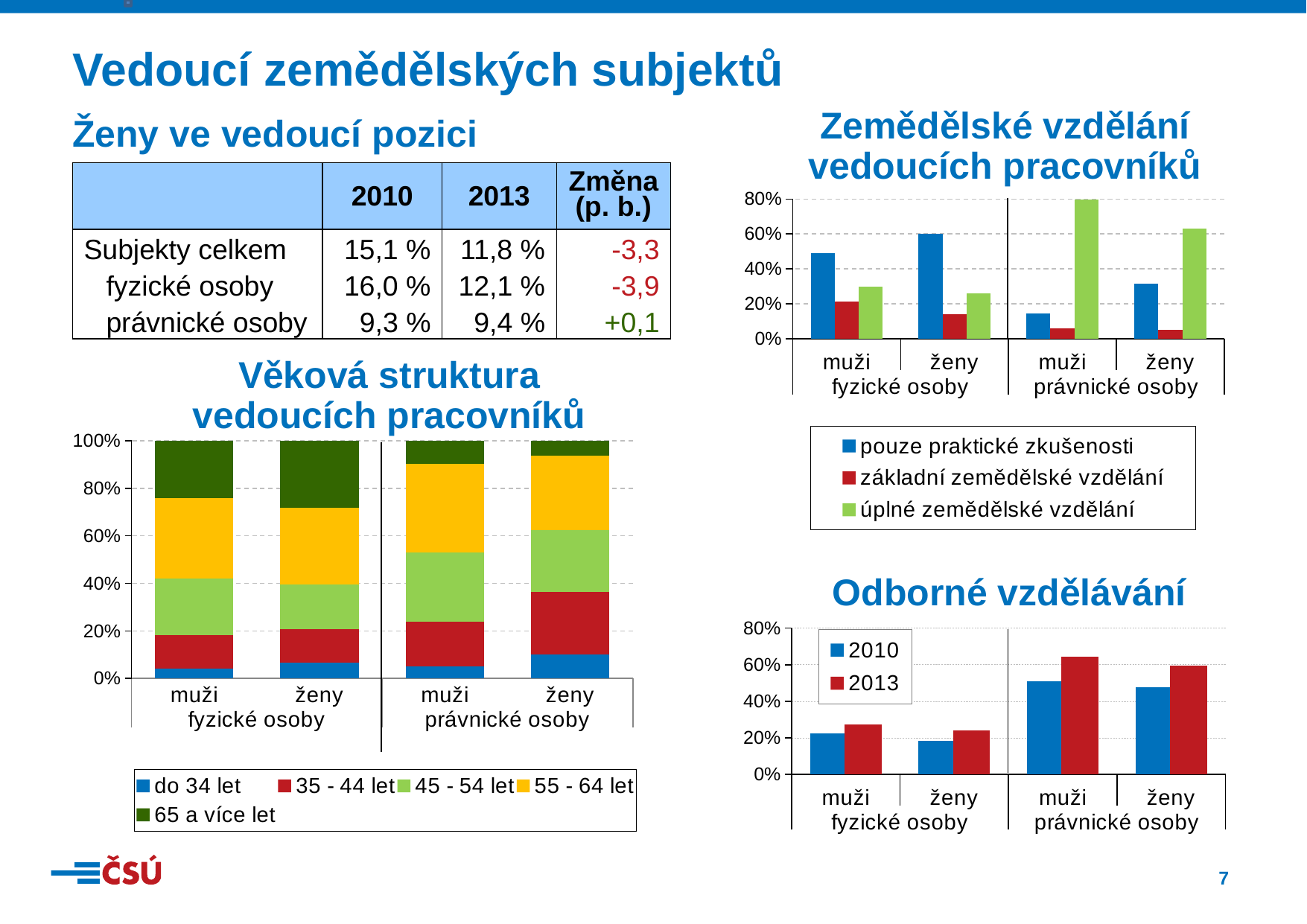
In the chart 'Věková struktura vedoucích pracovníků', how many age groups does the legend list? 5 In the chart 'Zemědělské vzdělání vedoucích pracovníků', how many categories are shown on the x axis? 4 In the chart 'Zemědělské vzdělání vedoucích pracovníků', for muži (fyzické osoby), which is larger: 'pouze praktické zkušenosti' or 'úplné zemědělské vzdělání'? pouze praktické zkušenosti In the chart 'Zemědělské vzdělání vedoucích pracovníků', is the value of 'pouze praktické zkušenosti' for ženy (fyzické osoby) greater or less than 40%? greater In the chart 'Odborné vzdělávání', which category has the highest value for 2013? muži, právnické osoby In the chart 'Odborné vzdělávání', how many series does the legend list? 2 In the chart 'Zemědělské vzdělání vedoucích pracovníků', which category has the highest value for 'úplné zemědělské vzdělání'? muži, právnické osoby In the chart 'Věková struktura vedoucích pracovníků', is the share of 'do 34 let' for muži (fyzické osoby) greater or less than 20%? less In the chart 'Zemědělské vzdělání vedoucích pracovníků', how many series does the legend list? 3 In the chart 'Zemědělské vzdělání vedoucích pracovníků', is the value of 'pouze praktické zkušenosti' for muži (právnické osoby) greater or less than 20%? less What kind of chart is 'Zemědělské vzdělání vedoucích pracovníků'? bar chart